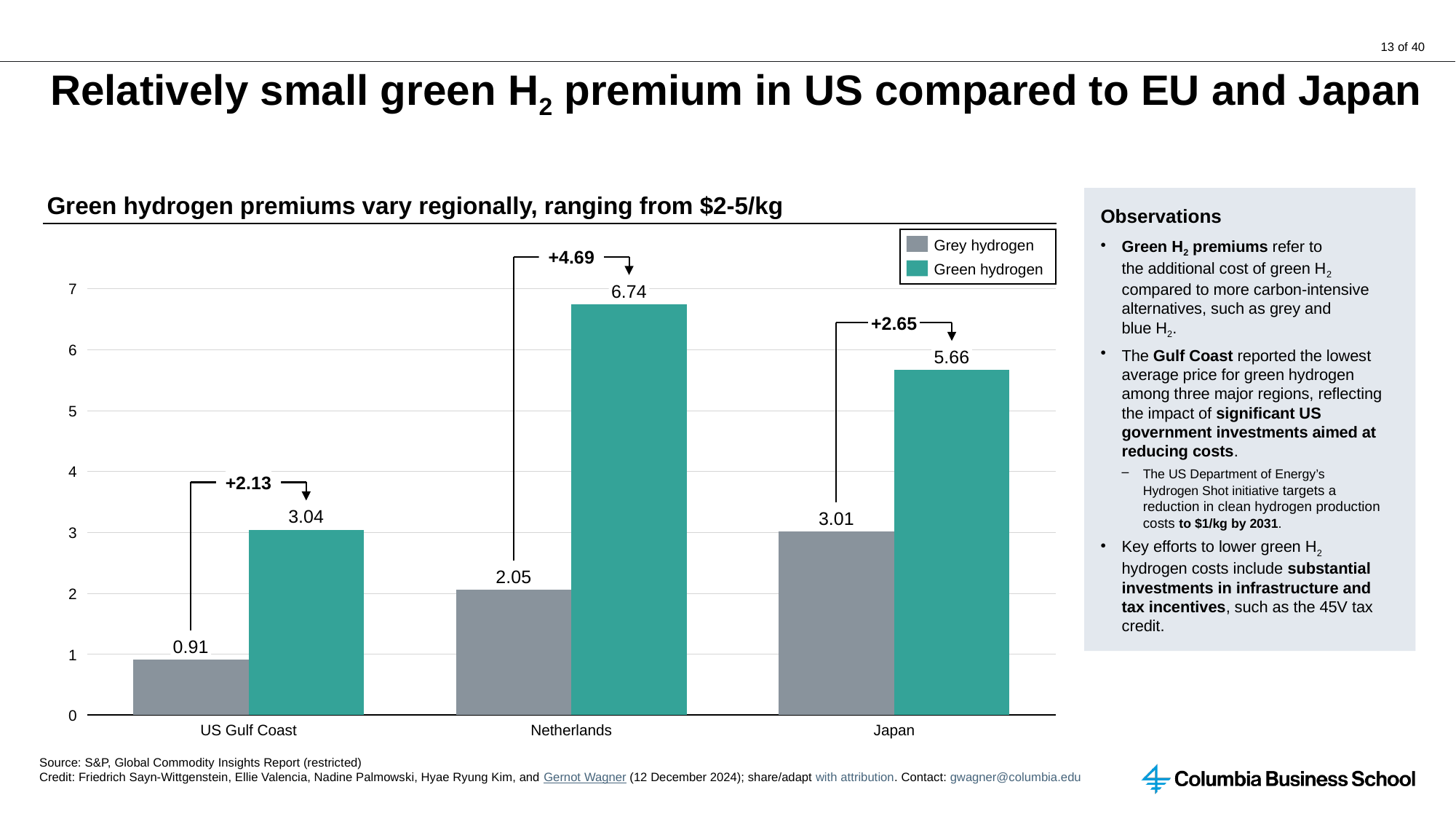
Which is larger: the Green hydrogen value for the US Gulf Coast or the Grey hydrogen value for Japan? Green hydrogen value for the US Gulf Coast How many regions are shown on the x axis? 3 What is the value for Grey hydrogen in the US Gulf Coast? 0.91 What is the value for Grey hydrogen in Japan? 3.01 What is the value for Green hydrogen in the Netherlands? 6.74 Which region has the highest Green hydrogen value? Netherlands What colour are the Green hydrogen bars? Teal Which region has the lowest Grey hydrogen value? US Gulf Coast Is the Green hydrogen value for Japan greater or less than 5? greater What is the difference between the Green hydrogen and Grey hydrogen values for Japan? 2.65 How many series does the legend list? 2 What kind of chart is shown on the slide? Bar chart